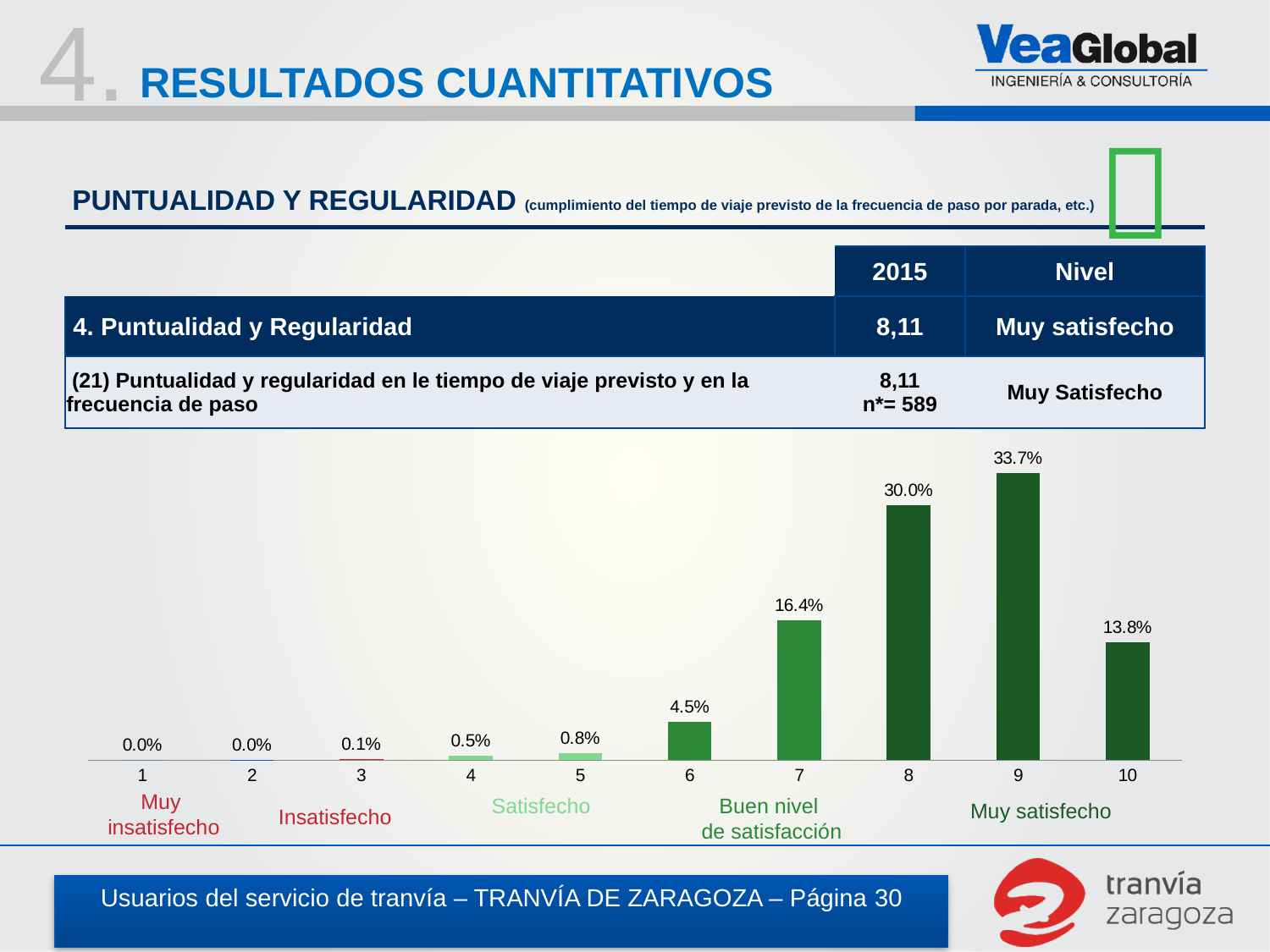
Which score has the highest percentage of respondents? 9 What is the difference in percentage points between scores 8 and 7? 13.6 What percentage of respondents gave a score of 6? 4.5% What percentage of respondents gave a score of 7? 16.4% Do the percentages rise or fall from score 1 to score 9? Rise What percentage of respondents gave a score of 9? 33.7% What percentage of respondents gave a score of 10? 13.8% What type of chart is shown on the slide? Bar chart Which has a higher percentage, score 7 or score 10? Score 7 What is the difference in percentage points between scores 9 and 8? 3.7 How many score categories are shown on the x axis of the chart? 10 What is the combined percentage for scores 8, 9 and 10? 77.5%